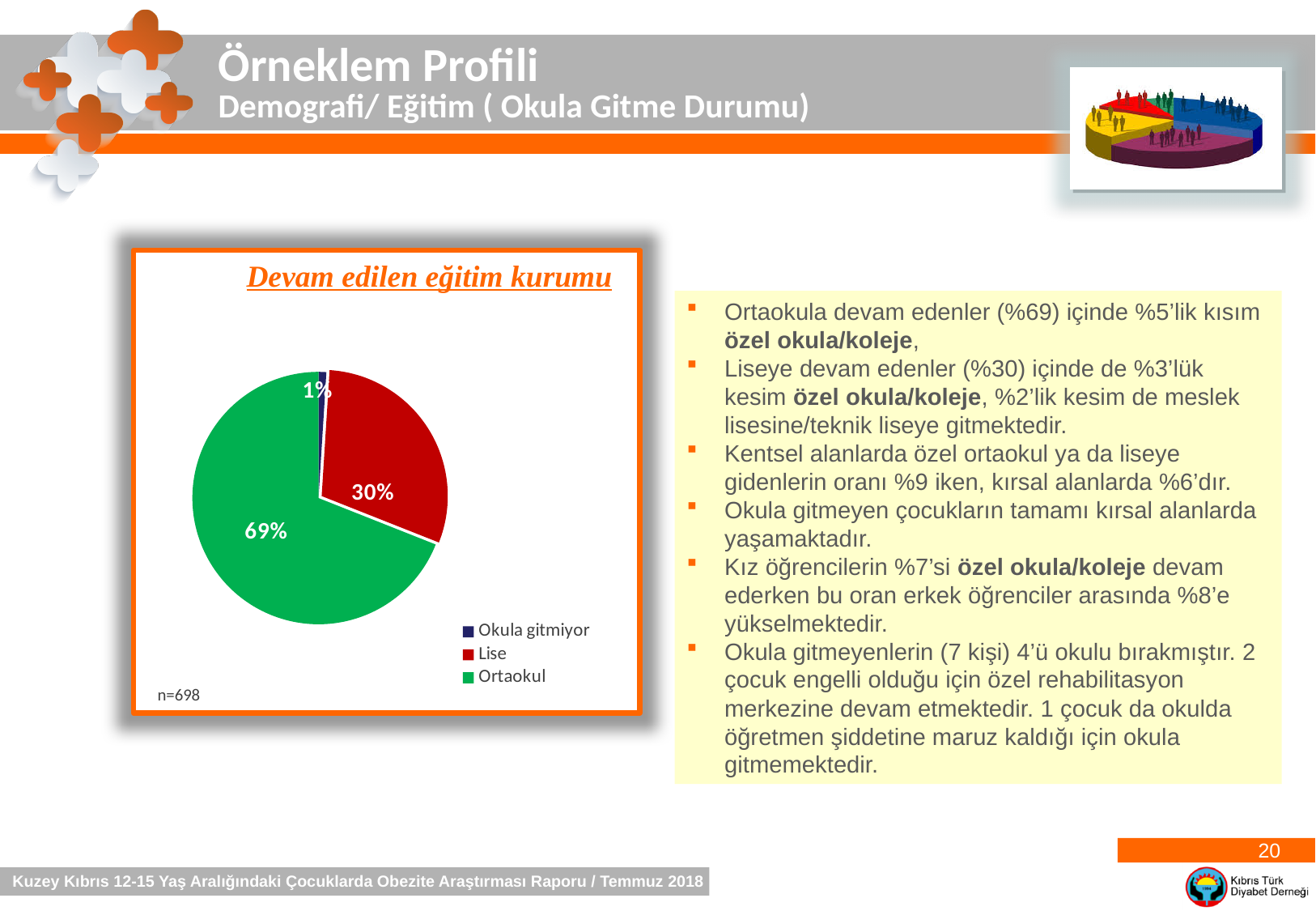
What share of the pie does Lise represent? 30% What kind of chart is shown on the slide? pie chart Which is larger, the share for Lise or the share for Okula gitmiyor? Lise What is the difference in percentage points between Lise and Okula gitmiyor? 29% What sample size (n) is noted on the chart? n=698 What is the title of the chart? Devam edilen eğitim kurumu What share of the pie does Okula gitmiyor represent? 1% How many categories does the pie chart show? 3 Which category has the smallest slice of the pie? Okula gitmiyor Which category has the largest slice of the pie? Ortaokul What is the difference in percentage points between Ortaokul and Lise? 39% What share of the pie does Ortaokul represent? 69%